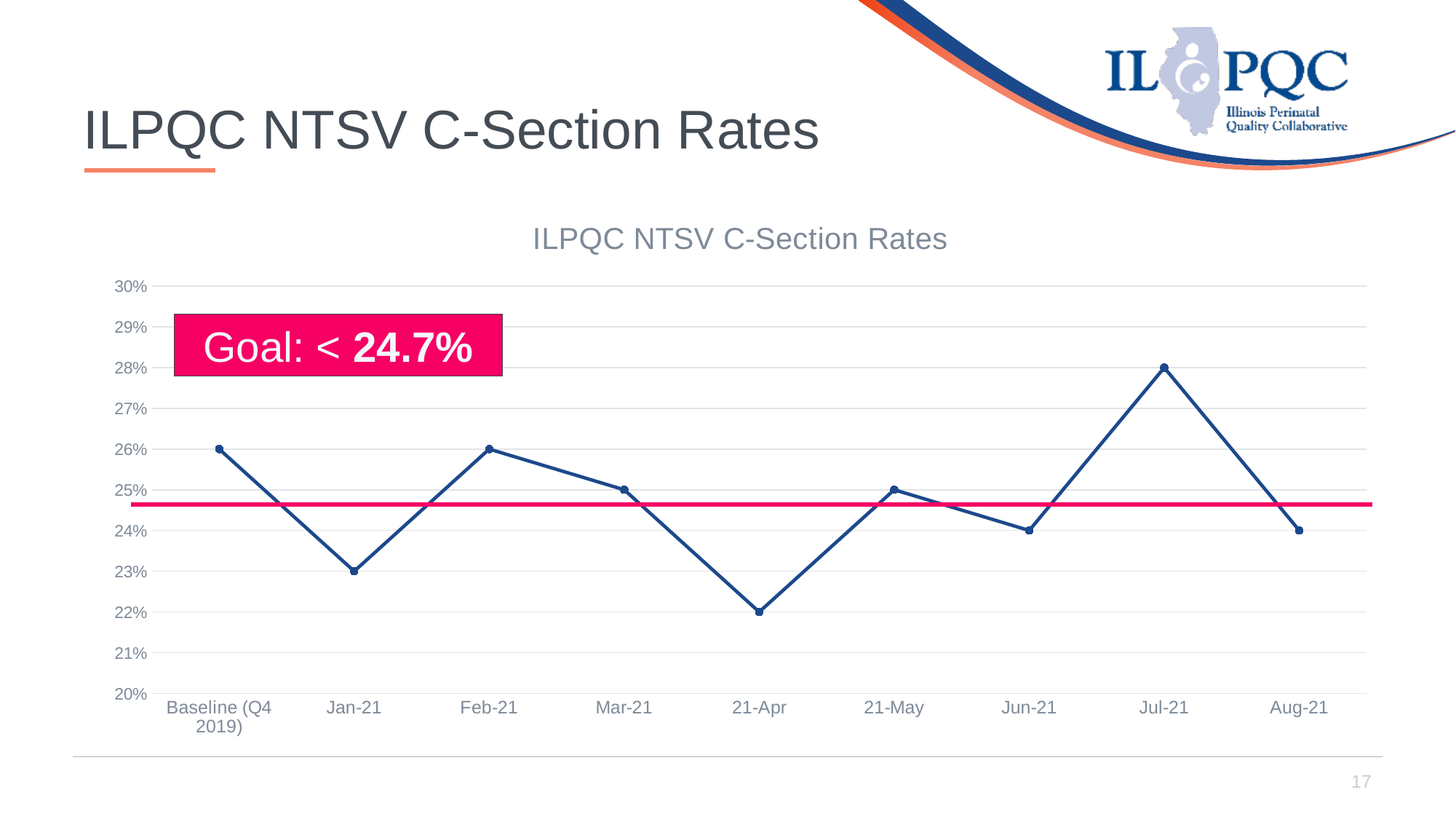
What is the title of the chart? ILPQC NTSV C-Section Rates What is the NTSV C-section rate for Jul-21? 28% What is the NTSV C-section rate for the Baseline (Q4 2019)? 26% What is the NTSV C-section rate for 21-Apr? 22% Which month has the lowest NTSV C-section rate? 21-Apr What is the difference between the Jul-21 rate and the Aug-21 rate? 4% What goal value is shown in the box on the chart? < 24.7% Which is larger, the rate for Feb-21 or the rate for Jun-21? Feb-21 How many data points are plotted on the line? 9 Is the value for Jan-21 greater or less than 24%? less What type of chart is shown on the slide? Line chart Which month has the highest NTSV C-section rate? Jul-21